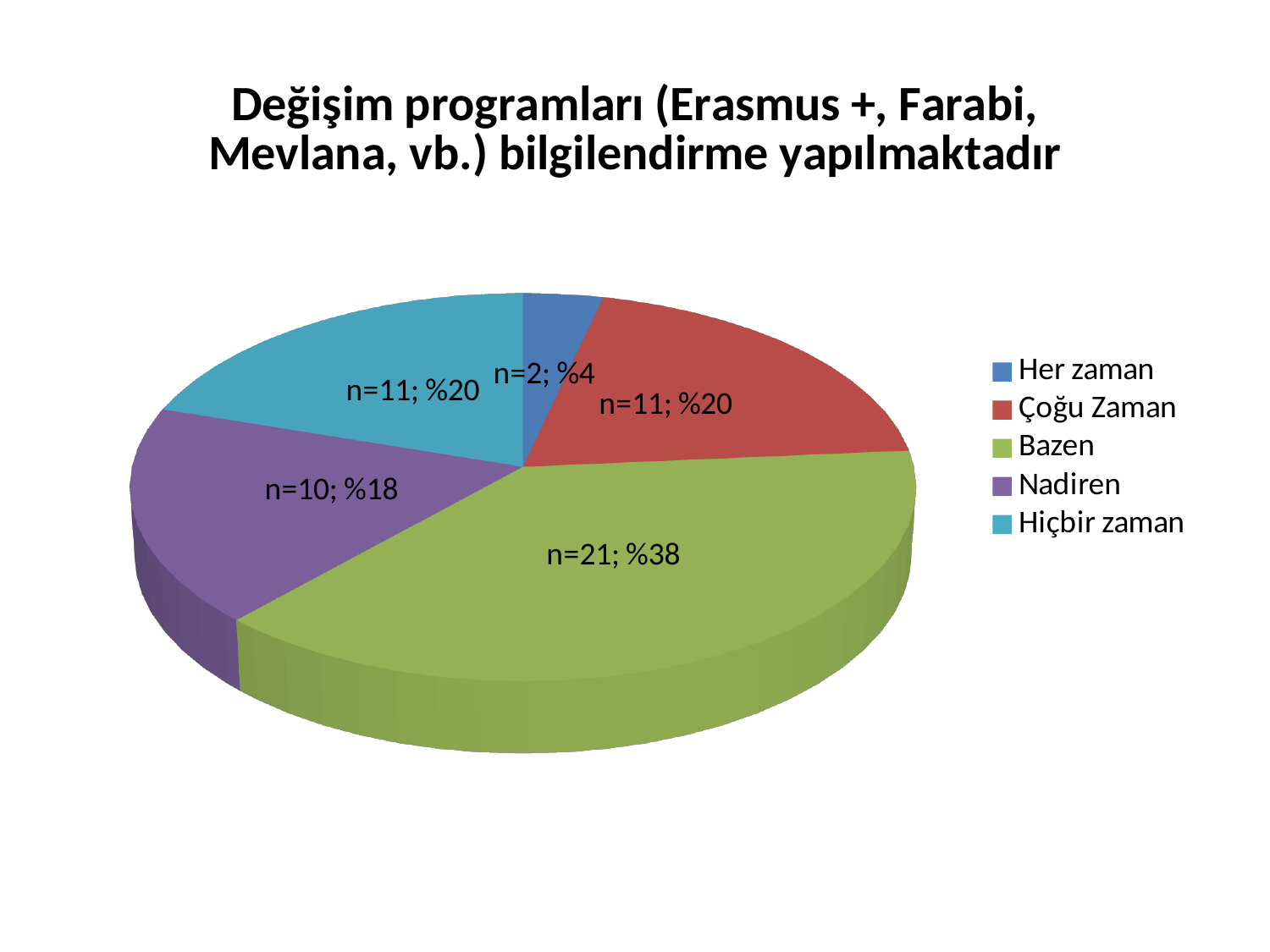
How many categories does the pie chart show? 5 What kind of chart is shown on the slide? Pie chart Which category has the smallest slice of the pie? Her zaman Which is larger, the Nadiren slice or the Hiçbir zaman slice? Hiçbir zaman What percentage share of the pie does Çoğu Zaman have? %20 What is the data label for the Her zaman slice? n=2; %4 What is the data label for the Nadiren slice? n=10; %18 Which category has the largest slice of the pie? Bazen Which colour represents Hiçbir zaman in the legend? Teal (light blue) What is the data label for the Bazen slice? n=21; %38 What is the difference in n between Bazen and Nadiren? 11 What is the total n across all slices of the pie? 55